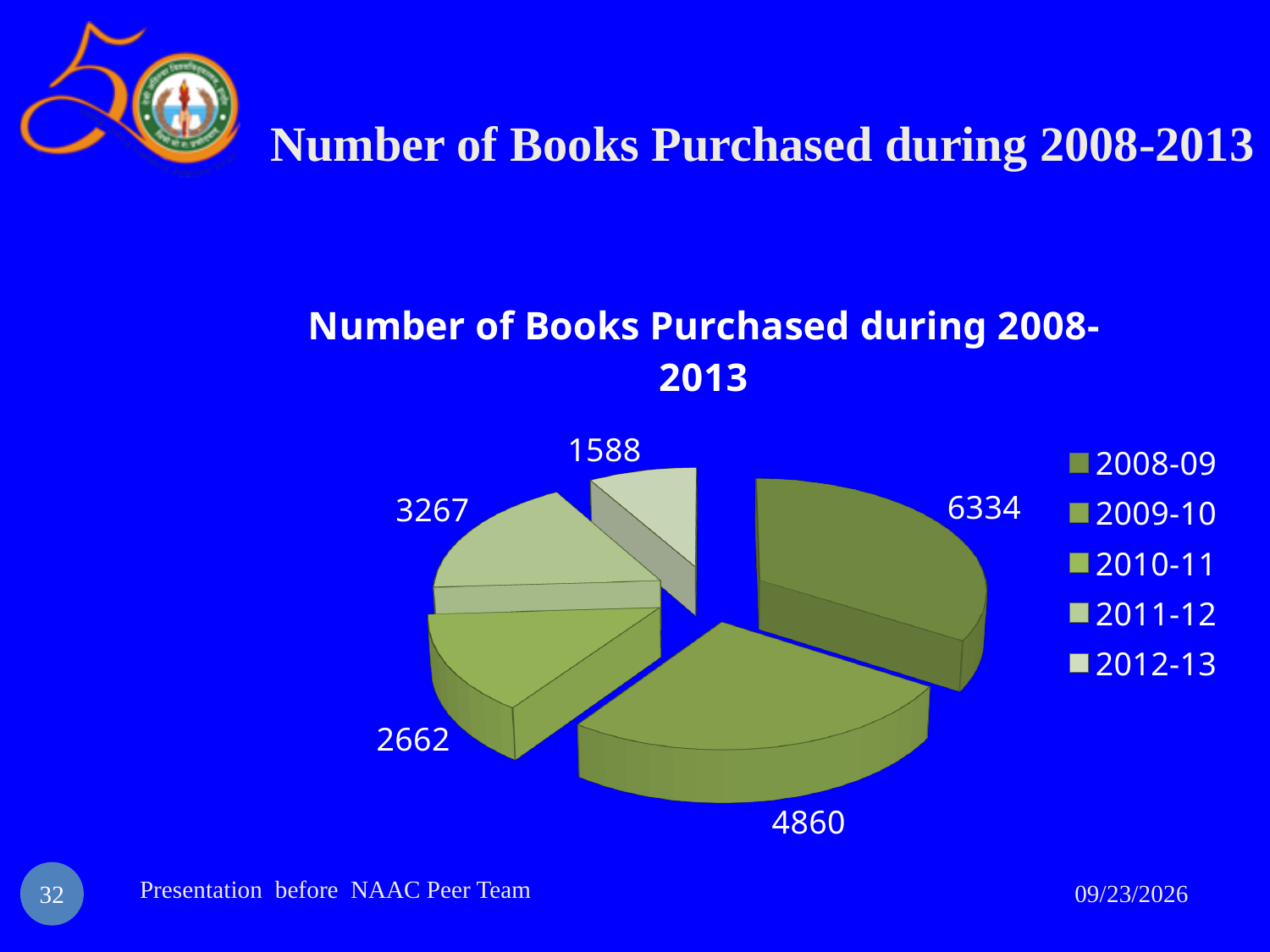
What type of chart is shown on the slide? pie chart Which year had the highest number of books purchased? 2008-09 How many books were purchased in 2008-09? 6334 Which year had the lowest number of books purchased? 2012-13 How many books were purchased in 2011-12? 3267 How many books were purchased in 2010-11? 2662 What is the title of the chart? Number of Books Purchased during 2008-2013 How many slices does the pie chart have? 5 What is the difference between the number of books purchased in 2008-09 and 2009-10? 1474 Which year had more books purchased, 2010-11 or 2011-12? 2011-12 How many books were purchased in 2009-10? 4860 How many books were purchased in 2012-13? 1588